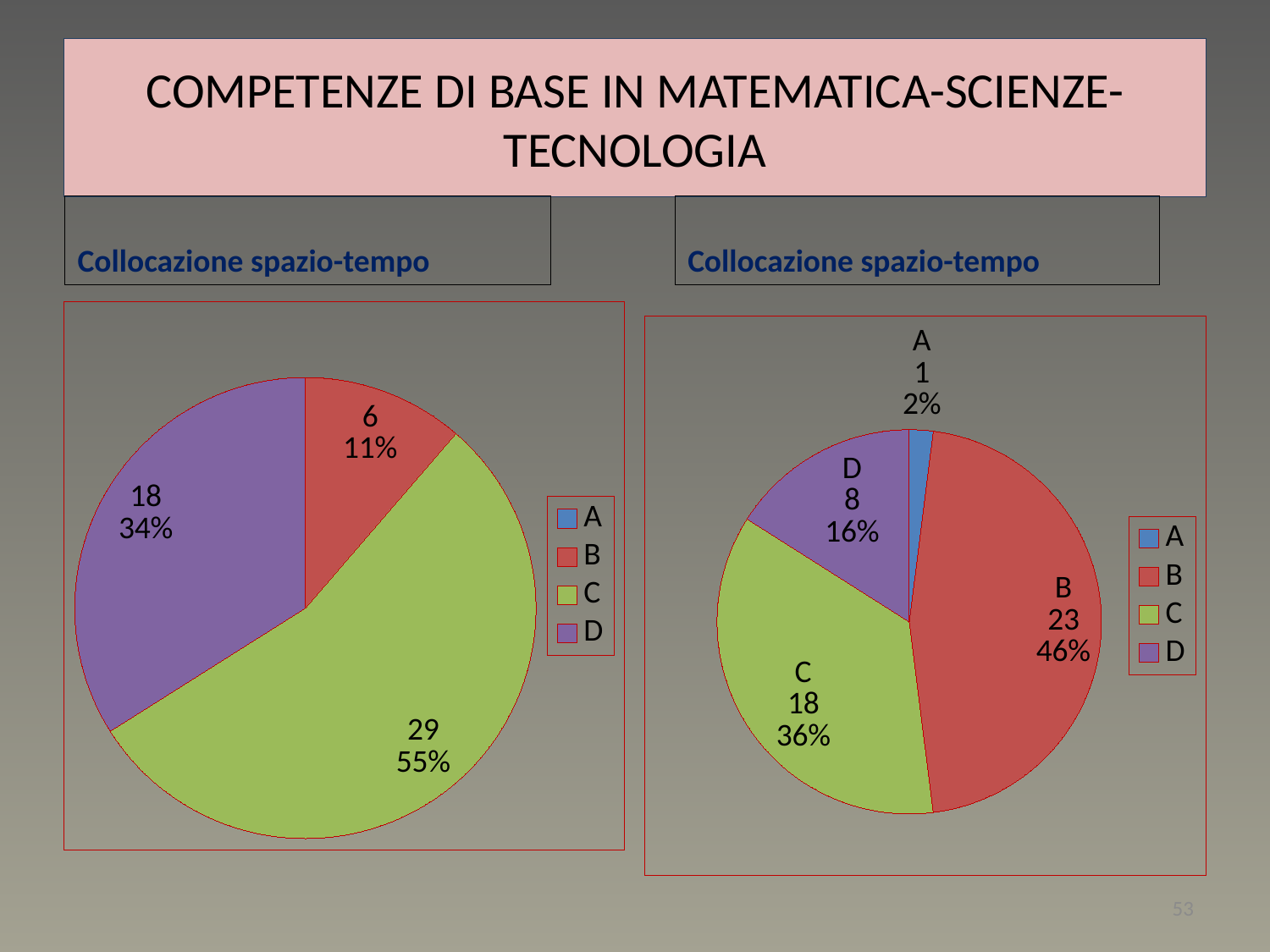
In the left pie chart, which category has the largest slice? C How many entries does the legend of the right pie chart list? 4 What type of chart is shown on the left side of the slide? Pie chart In the right pie chart, what percentage share does category A have? 2% In the left pie chart, which is larger, the value for B or the value for D? D In the left pie chart, what percentage share does category D have? 34% In the right pie chart, which is larger, the value for C or the value for D? C In the right pie chart, what is the difference between the values for B and C? 5 In the right pie chart, which category has the smallest slice? A In the left pie chart, what value is shown for category C? 29 In the left pie chart, what is the difference between the values for C and D? 11 In the right pie chart, what value is shown for category B? 23